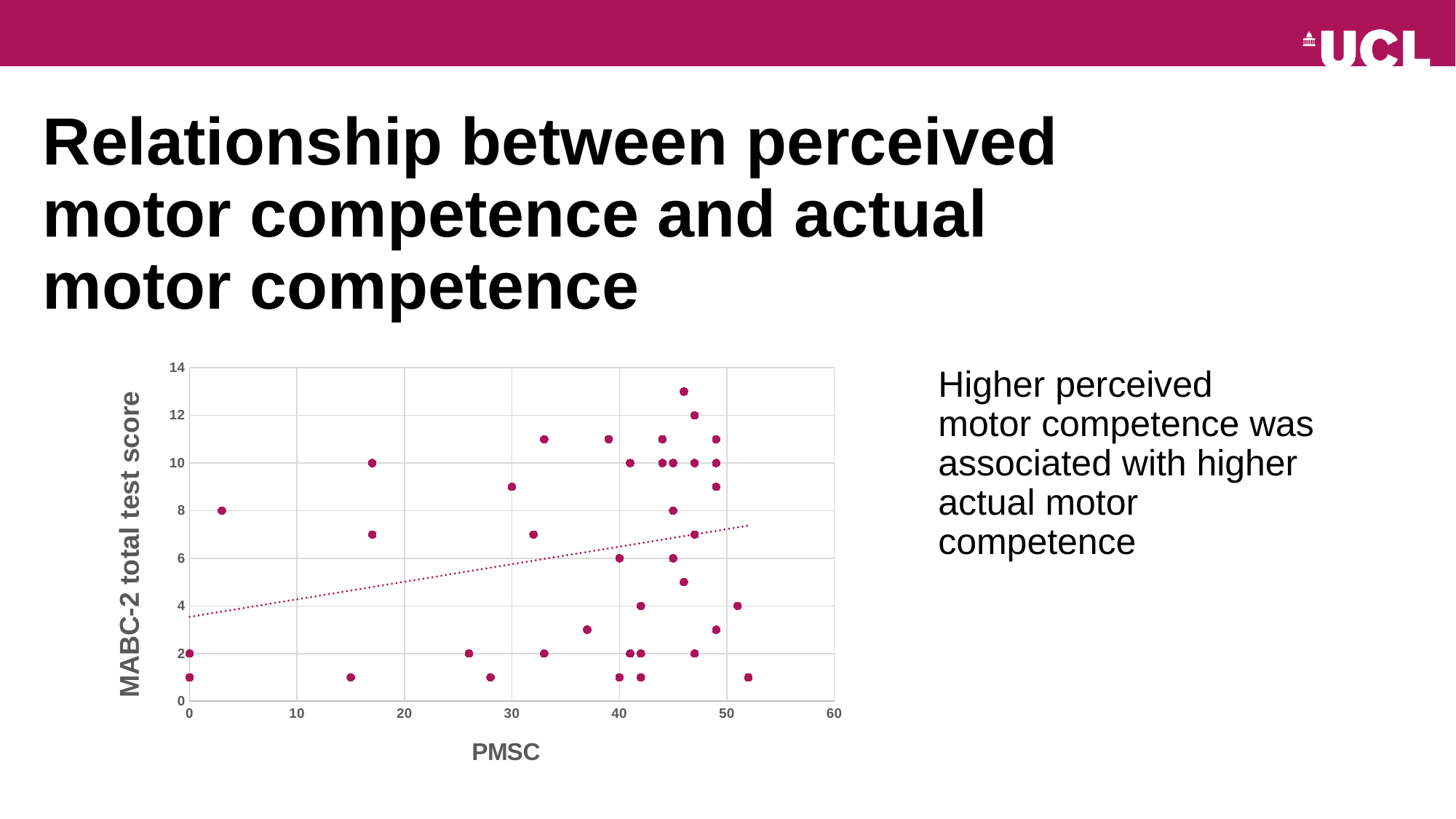
What is the title of the x axis of the chart? PMSC What is the highest MABC-2 total test score among the points plotted at PMSC 0? 2 At PMSC 50, is the trend line's value greater or less than 6? greater Where the trend line meets PMSC 0, is its value greater or less than 4? less What kind of chart is shown on the slide? scatter chart Is the MABC-2 total test score of the highest plotted point greater or less than 12? greater What is the maximum value shown on the y axis? 14 Does the dotted trend line rise or fall as PMSC increases? rises What is the title of the y axis of the chart? MABC-2 total test score